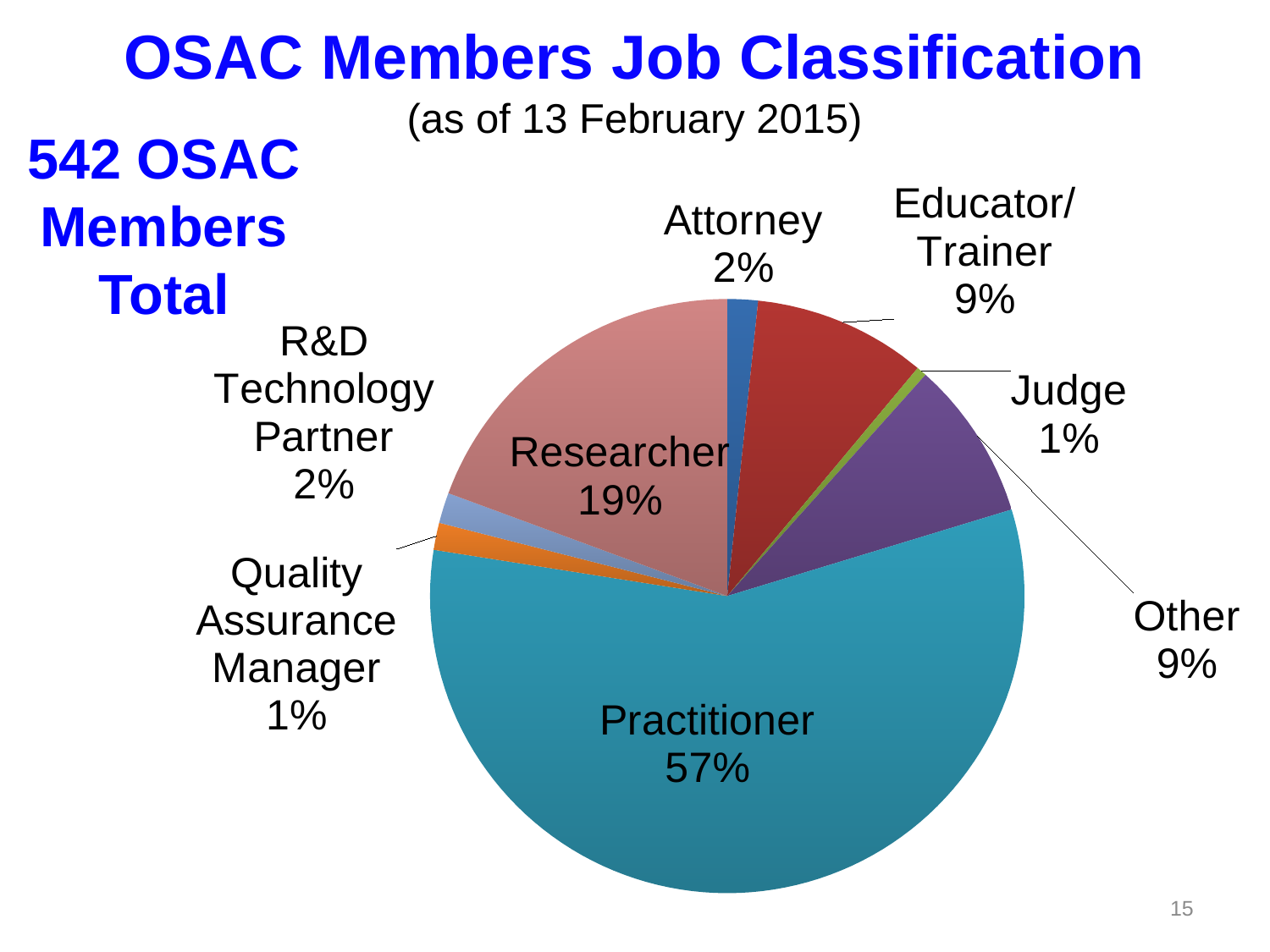
Which is larger, the share for Researcher or the share for Educator/Trainer? Researcher What is the title of the chart? OSAC Members Job Classification What kind of chart is shown on the slide? Pie chart What share of OSAC members are Practitioners? 57% What percentage is shown for Quality Assurance Manager? 1% How many job classification categories are shown in the pie chart? 8 What percentage of OSAC members are Researchers? 19% What is the difference in percentage points between Practitioner and Researcher? 38 What percentage is shown for Attorney? 2% Which job classification has the largest share of OSAC members? Practitioner How many OSAC members in total does the slide report? 542 What share of the pie is Educator/Trainer? 9%